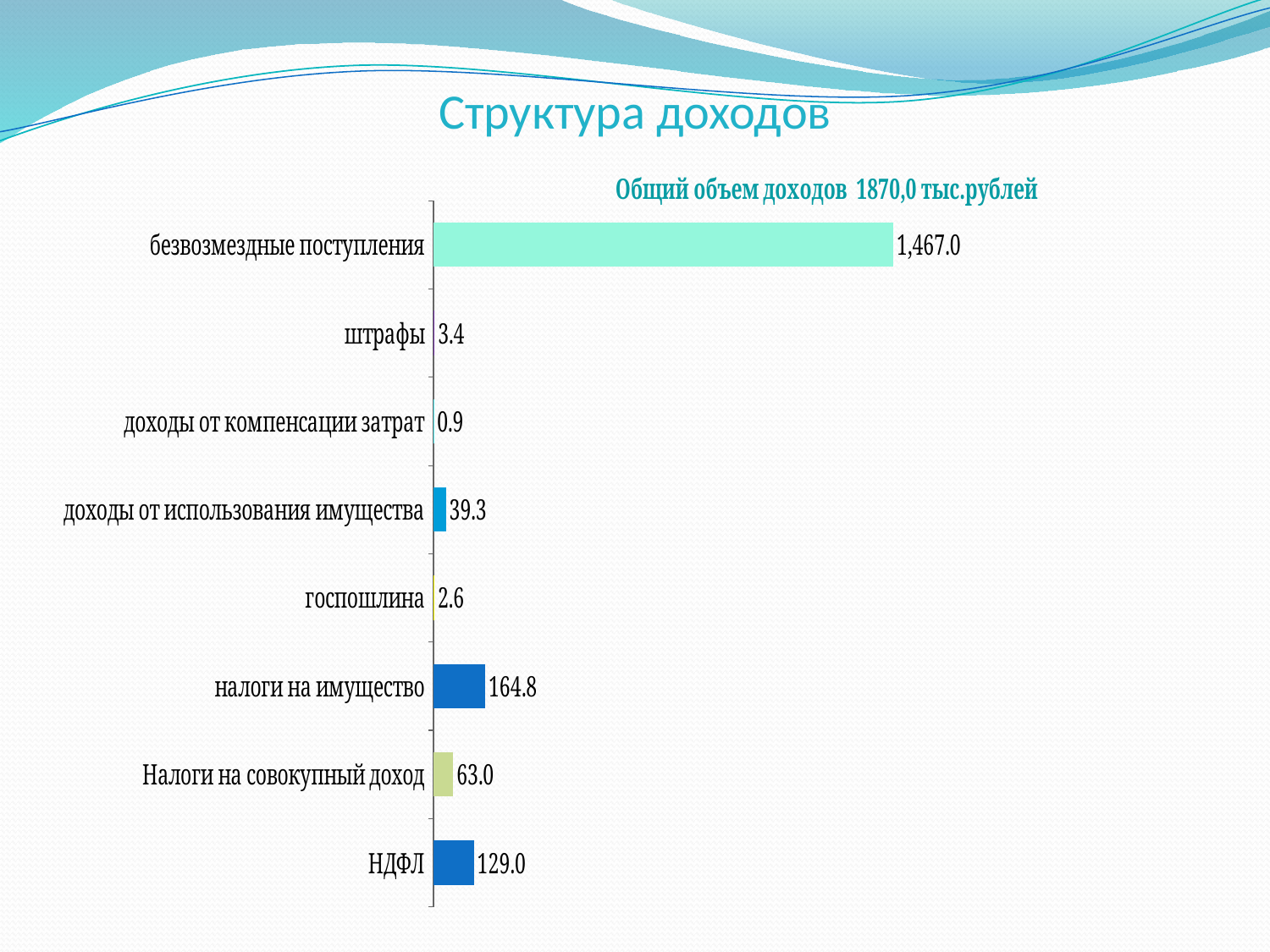
What kind of chart is shown on the slide? bar chart What is the title of the chart? Общий объем доходов 1870,0 тыс.рублей How many categories are shown in the chart? 8 What is the value for безвозмездные поступления? 1,467.0 What is the value for штрафы? 3.4 Which category has the lowest value? доходы от компенсации затрат Which category has the highest value? безвозмездные поступления What is the value for доходы от использования имущества? 39.3 What is the difference between налоги на имущество and НДФЛ? 35.8 Which is larger, Налоги на совокупный доход or доходы от использования имущества? Налоги на совокупный доход What is the value for налоги на имущество? 164.8 What is the value for НДФЛ? 129.0